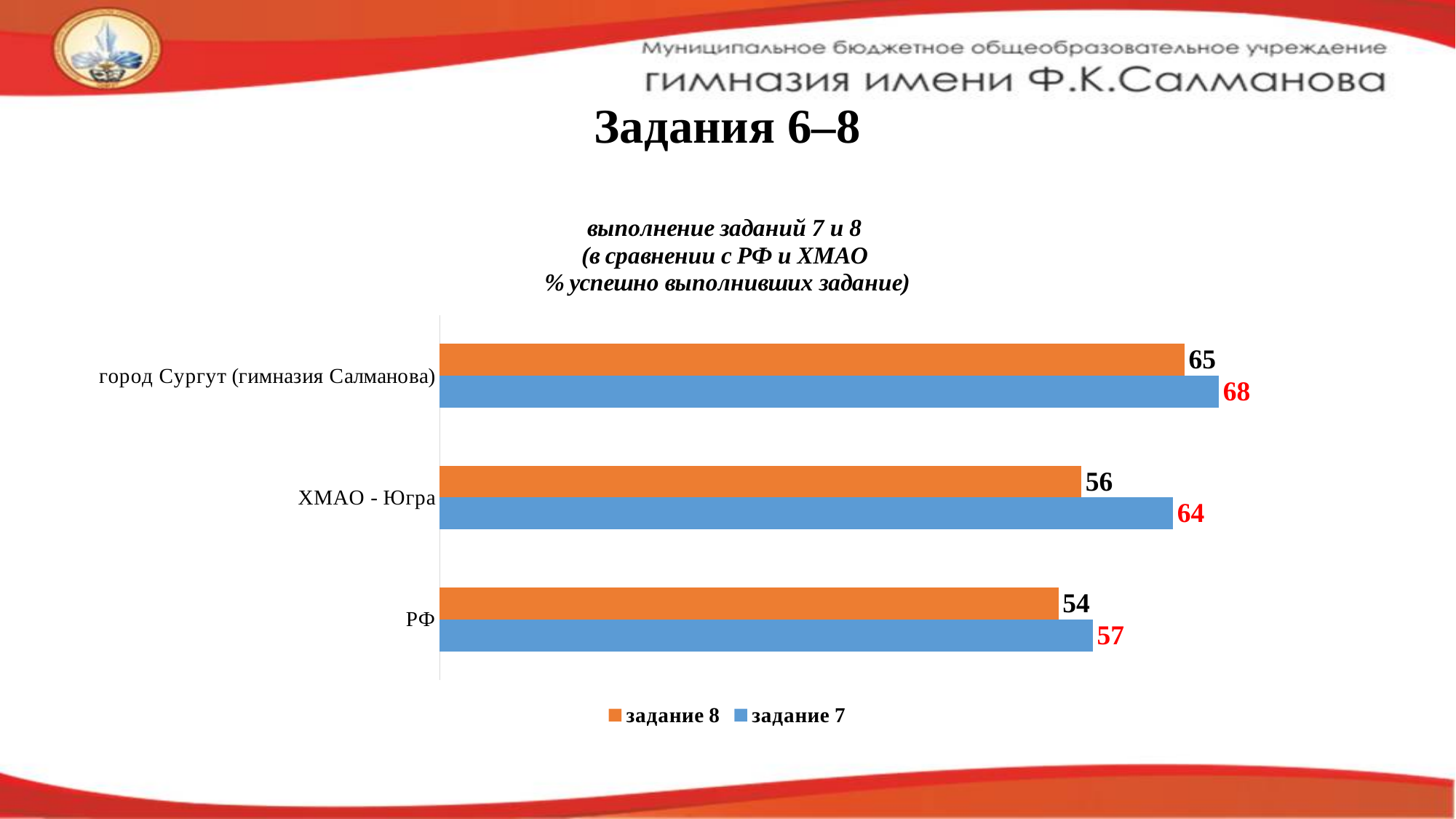
What is the value for задание 8 for ХМАО - Югра? 56 What is the difference between the задание 7 values for город Сургут (гимназия Салманова) and РФ? 11 How many categories are shown on the chart? 3 Which is larger for город Сургут (гимназия Салманова): задание 8 or задание 7? задание 7 What is the value for задание 8 for РФ? 54 What is the value for задание 7 for город Сургут (гимназия Салманова)? 68 What kind of chart is shown on the slide? bar chart How many series does the legend list? 2 Which category has the highest value for задание 7? город Сургут (гимназия Салманова) What is the value for задание 7 for РФ? 57 What is the difference between задание 7 and задание 8 for ХМАО - Югра? 8 Which category has the lowest value for задание 8? РФ